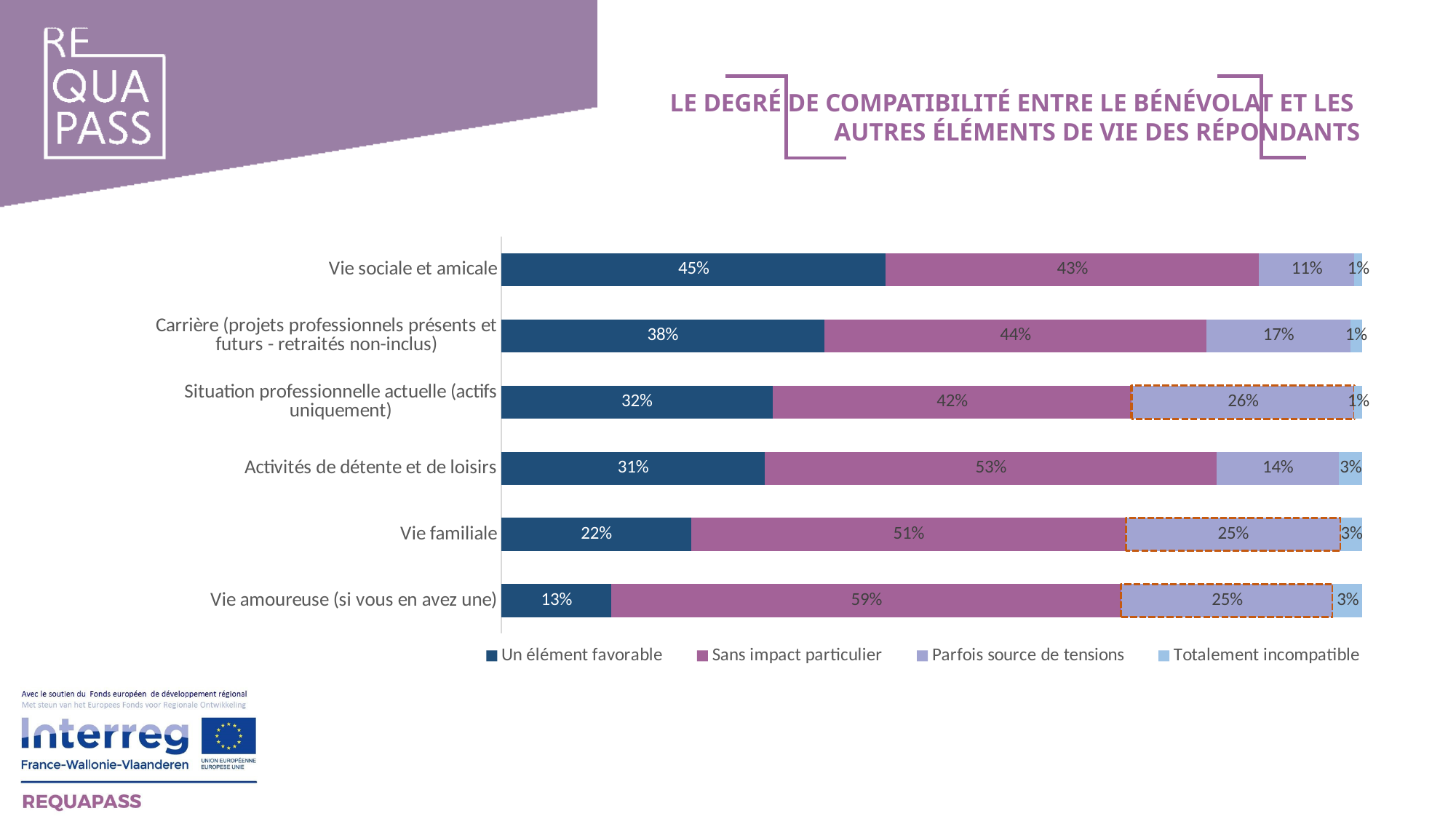
What is the 'Totalement incompatible' value for 'Activités de détente et de loisirs'? 3% How many series does the legend list? 4 What is the difference between the 'Sans impact particulier' values for 'Activités de détente et de loisirs' and 'Vie sociale et amicale'? 10% Which category has the highest 'Un élément favorable' value? Vie sociale et amicale Which category has the lowest 'Un élément favorable' value? Vie amoureuse (si vous en avez une) Which legend entry is shown in the darkest blue colour? Un élément favorable How many categories are shown on the chart? 6 What is the 'Sans impact particulier' value for 'Vie amoureuse (si vous en avez une)'? 59% What kind of chart is shown on the slide? Stacked bar chart Which is larger: the 'Parfois source de tensions' value for 'Carrière (projets professionnels présents et futurs - retraités non-inclus)' or for 'Vie familiale'? Vie familiale What percentage of respondents consider volunteering 'Un élément favorable' for 'Vie sociale et amicale'? 45% What is the 'Parfois source de tensions' value for 'Situation professionnelle actuelle (actifs uniquement)'? 26%